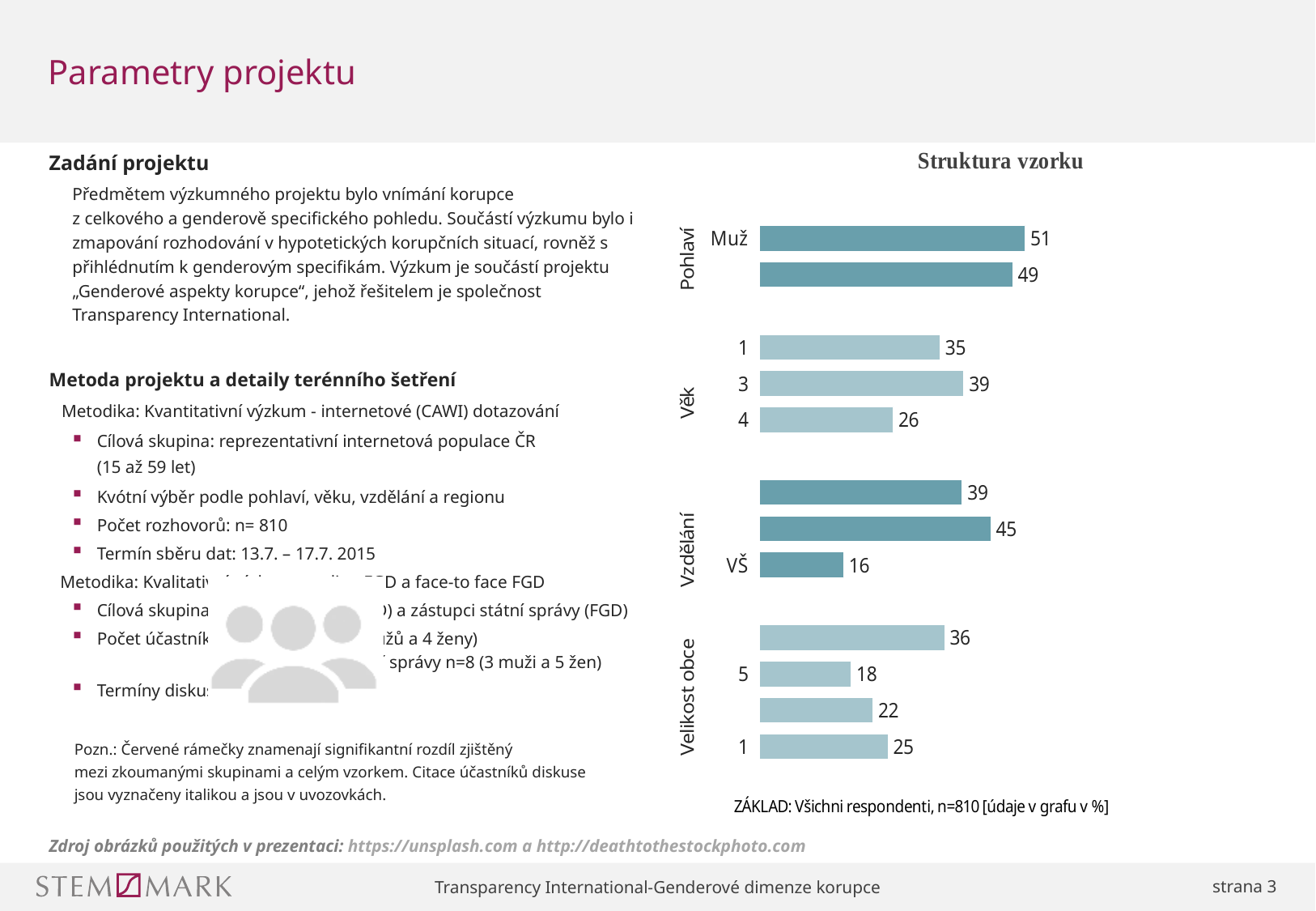
What is the lowest value shown in the Velikost obce group of the Struktura vzorku chart? 18 What is the value for Muž in the Struktura vzorku chart? 51 How many bars are in the Věk group of the Struktura vzorku chart? 3 What is the title of the chart on the slide? Struktura vzorku Which is larger in the Struktura vzorku chart, the value for Muž or the value for VŠ? Muž Which bar has the lowest value in the Struktura vzorku chart? VŠ What kind of chart is shown on the slide? bar chart How many bars are plotted in the Struktura vzorku chart in total? 12 Which bar has the highest value in the Struktura vzorku chart? Muž What is the difference between the values for Muž and VŠ in the Struktura vzorku chart? 35 What is the value for VŠ in the Struktura vzorku chart? 16 What is the highest value shown in the Vzdělání group of the Struktura vzorku chart? 45